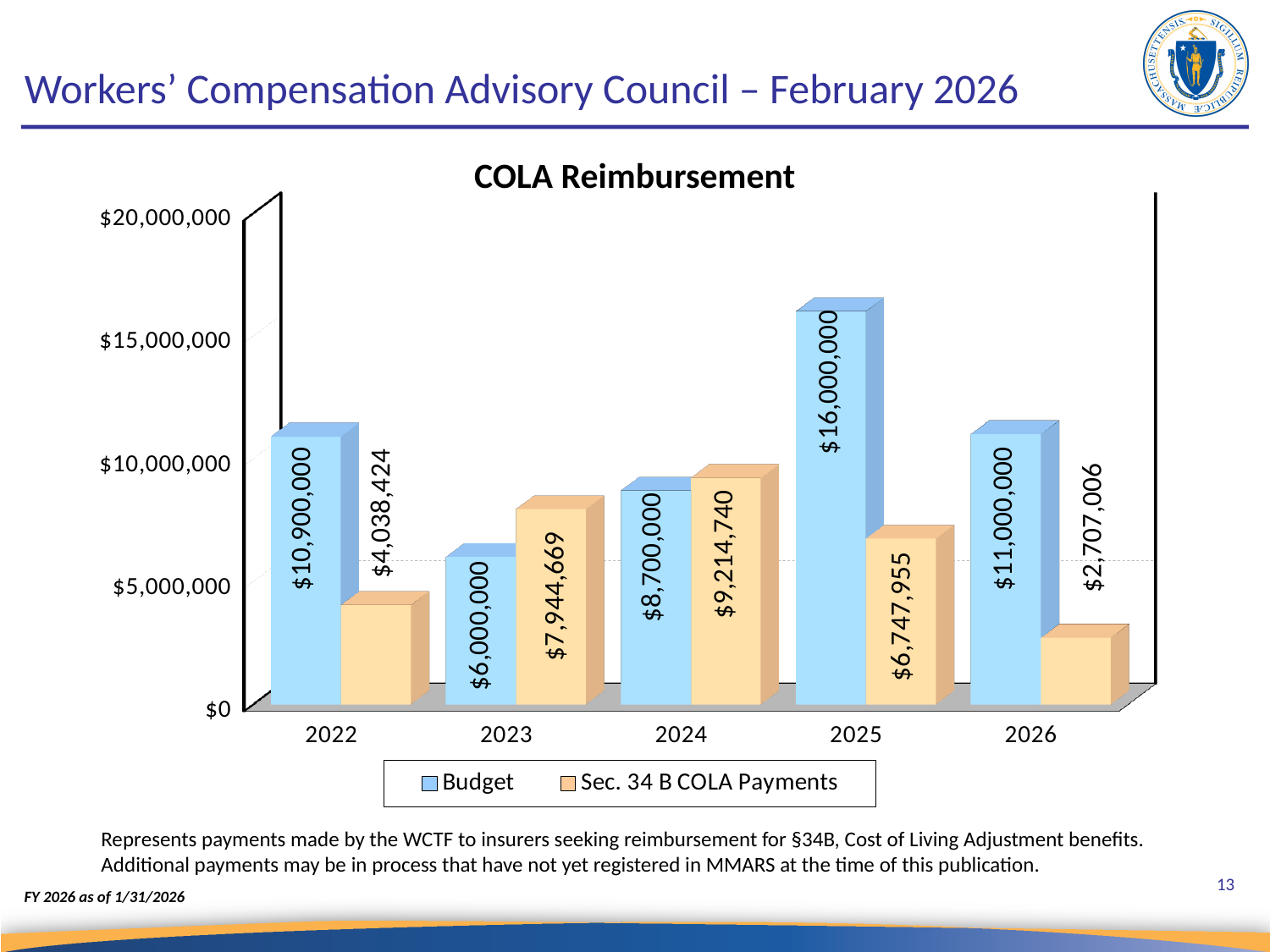
What is the difference between the Sec. 34 B COLA Payments and the Budget in 2024? $514,740 What is the Budget value for 2025? $16,000,000 How many years are shown on the x axis? 5 Which year has the lowest Sec. 34 B COLA Payments value? 2026 How many series does the legend list? 2 What is the difference between the Budget and the Sec. 34 B COLA Payments in 2025? $9,252,045 What is the Sec. 34 B COLA Payments value for 2023? $7,944,669 What is the Sec. 34 B COLA Payments value for 2026? $2,707,006 Which year has the highest Budget value? 2025 What is the title of the chart? COLA Reimbursement In 2023, which is larger: the Budget or the Sec. 34 B COLA Payments? Sec. 34 B COLA Payments What kind of chart is shown on the slide? Bar chart